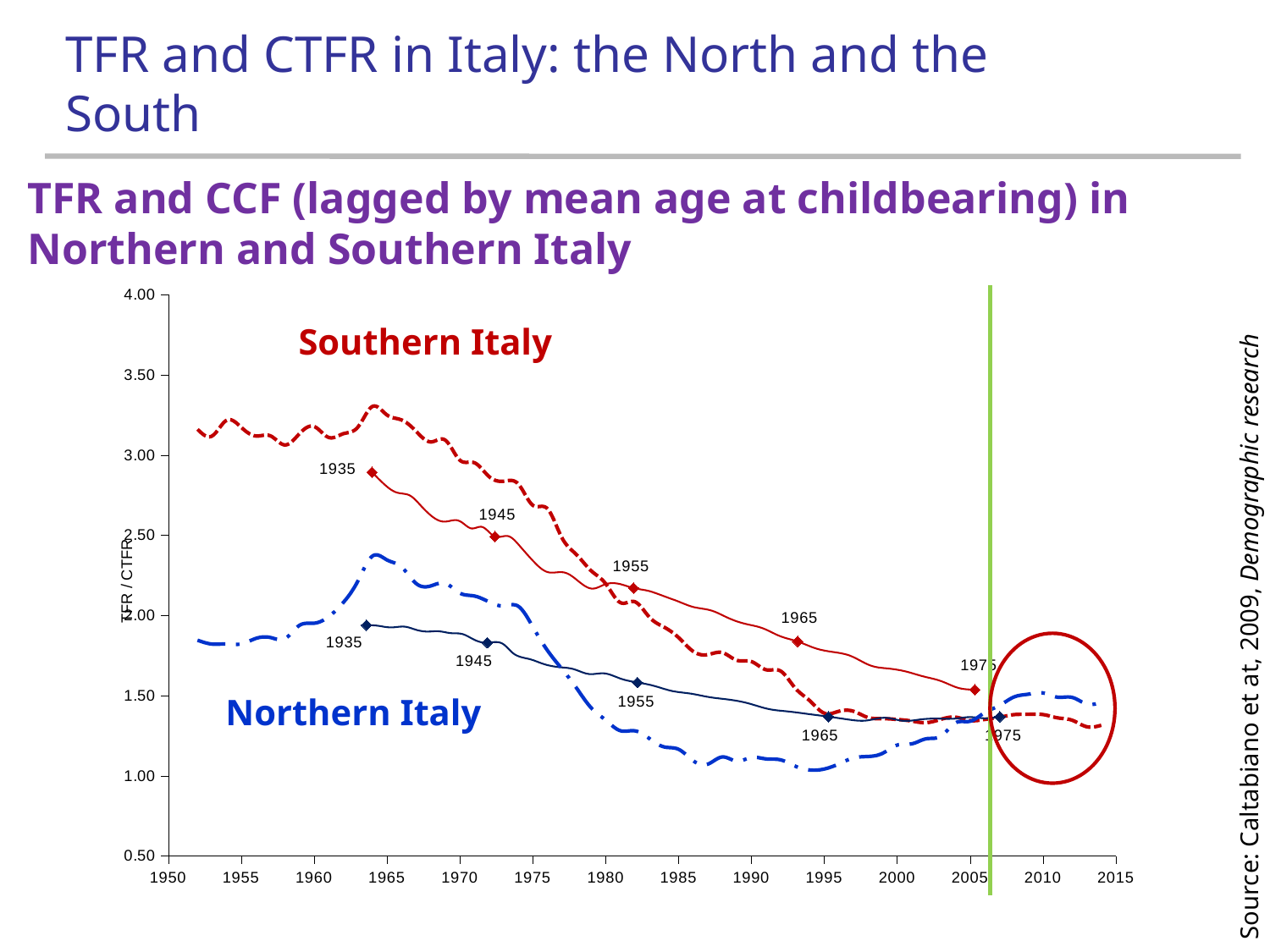
What is the title of the chart? TFR and CCF (lagged by mean age at childbearing) in Northern and Southern Italy Around 1960, which region has the higher TFR, Southern Italy or Northern Italy? Southern Italy What is the label on the vertical axis of the chart? TFR / CTFR Does the Southern Italy dashed TFR line rise or fall between 1965 and 2005? fall Is the value at the 1935 cohort marker on the Southern Italy CCF line greater or less than 2.50? greater Is the value at the 1935 cohort marker on the Northern Italy CCF line greater or less than 1.50? greater How many cohort years are labelled along each CCF line (1935, 1945, ...)? 5 What kind of chart is shown on the slide? line chart Is the value of the Northern Italy dash-dot TFR line around 1990 greater or less than 1.50? less What is the highest value shown on the vertical axis of the chart? 4.00